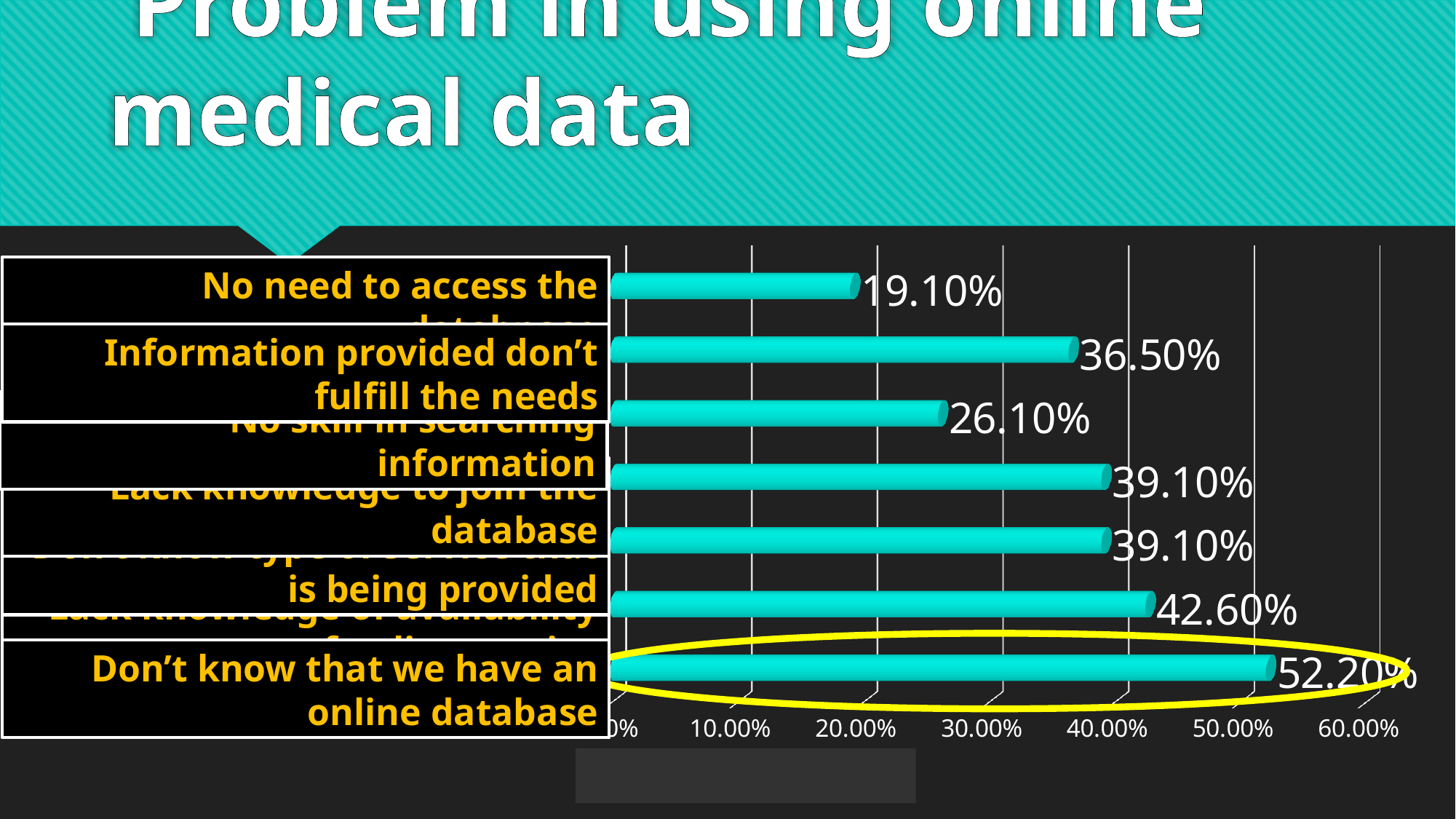
What kind of chart is shown on the slide? bar chart What is the value for "Information provided don't fulfill the needs"? 36.50% How many bars have a value above 40.00%? 2 Is the value for "Don't know that we have an online database" greater or less than 50.00%? greater What is the difference between the values for "Information provided don't fulfill the needs" and "No need to access the database"? 17.40% What is the value for "No need to access the database"? 19.10% What is the difference between the values for "Don't know that we have an online database" and "No need to access the database"? 33.10% How many bars are plotted in the chart? 7 Which category has the lowest value? No need to access the database Which category has the highest value? Don't know that we have an online database Which is larger: the value for "Information provided don't fulfill the needs" or for "No need to access the database"? Information provided don't fulfill the needs What is the value for "Don't know that we have an online database"? 52.20%